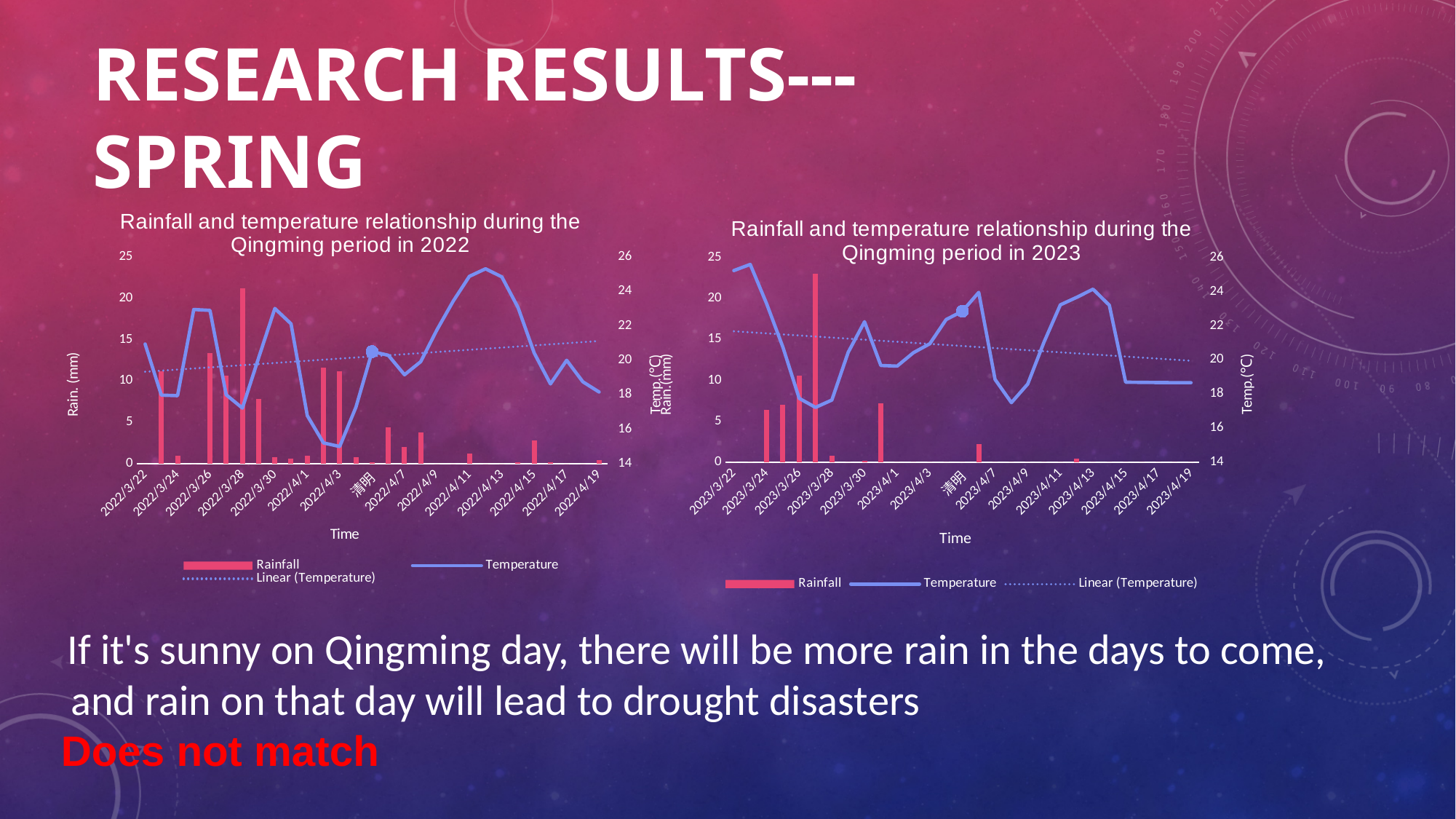
On the 2023 chart, what is the title of the left vertical axis? Rain.(mm) What kind of chart is the 'Rainfall and temperature relationship during the Qingming period in 2022' chart? A combined bar and line chart On the 2023 chart, does the Linear (Temperature) trendline rise or fall along the x axis? fall On the 2022 chart, is the rainfall bar at 2022/3/22 greater or less than 5? less How many series does the legend list on the 'Rainfall and temperature relationship during the Qingming period in 2023' chart? 3 On the 2023 chart, is the temperature at 2023/3/22 greater or less than 22? greater On the 2022 chart, is the tallest rainfall bar greater or less than 20? greater On the 2022 chart, does the Linear (Temperature) trendline rise or fall along the x axis? rise On the 2022 chart, which series is drawn as bars? Rainfall